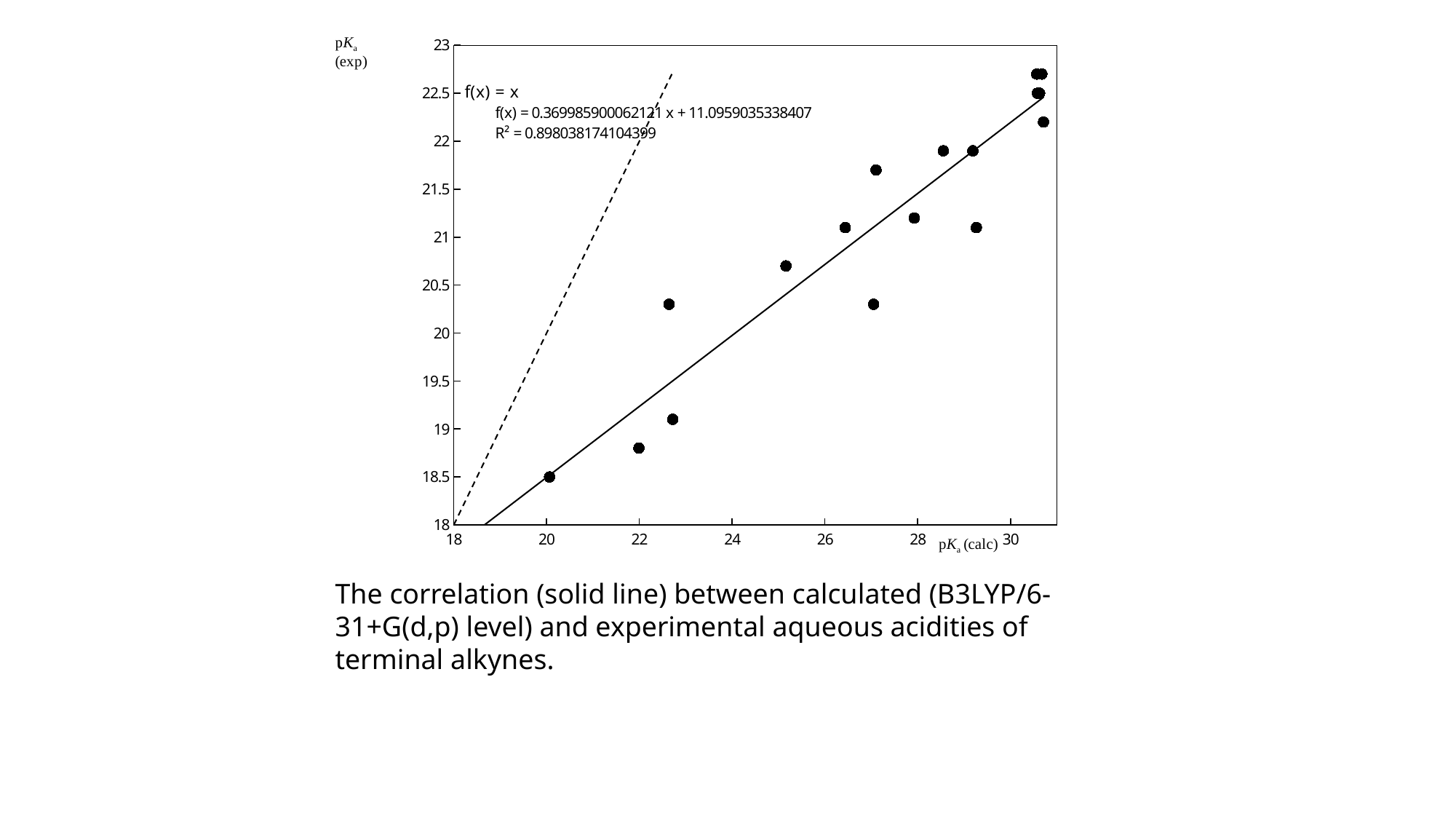
What is the label of the x axis of the chart? pKa (calc) What is the label of the y axis of the chart? pKa (exp) What is the equation of the dashed line printed on the chart? f(x) = x Is the pKa (exp) value of the point at pKa (calc) of about 25 greater or less than 20.5? greater Is the pKa (exp) value of the point at pKa (calc) of about 20 greater or less than 19? less Is the lowest plotted pKa (exp) value greater or less than 19? less What kind of chart is shown on the slide? scatter chart Do the plotted pKa (exp) values generally rise or fall as pKa (calc) increases along the x axis? rise What is the R² value printed on the chart for the solid regression line? 0.898038174104399 Which has the larger pKa (exp) value: the point at pKa (calc) of about 20 or the point at pKa (calc) of about 25? the point at pKa (calc) of about 25